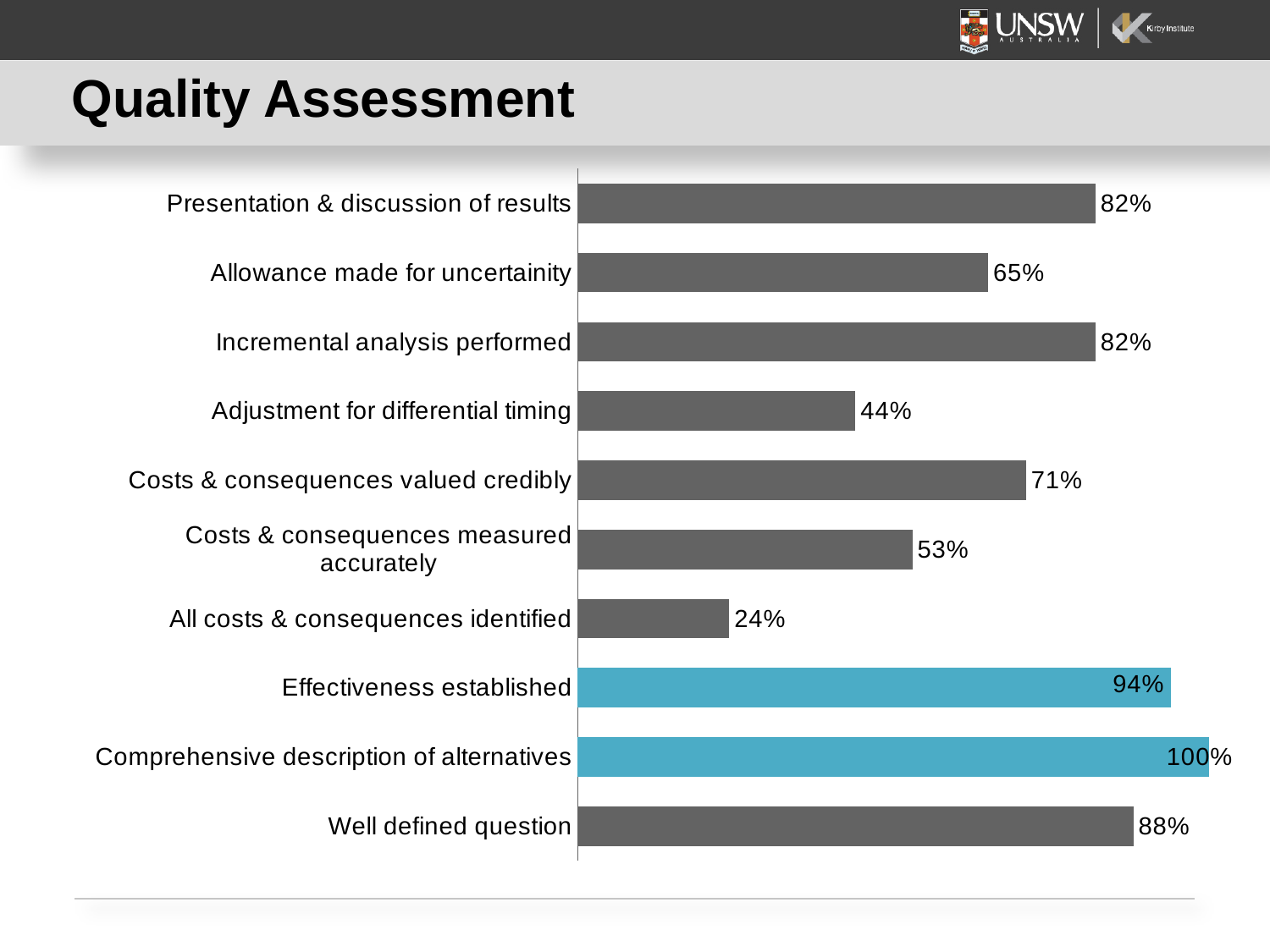
What is the value for All costs & consequences identified? 24% Which category has the highest value? Comprehensive description of alternatives Which category has the lowest value? All costs & consequences identified What is the value for Adjustment for differential timing? 44% What is the difference between the values for Effectiveness established and Allowance made for uncertainty? 29% What is the value for Effectiveness established? 94% Which is larger, the value for Costs & consequences valued credibly or the value for Costs & consequences measured accurately? Costs & consequences valued credibly Which two categories have bars coloured blue rather than grey? Effectiveness established and Comprehensive description of alternatives What is the value for Well defined question? 88% How many categories are shown in the chart? 10 What kind of chart is shown on the slide? Bar chart What is the title of the slide? Quality Assessment